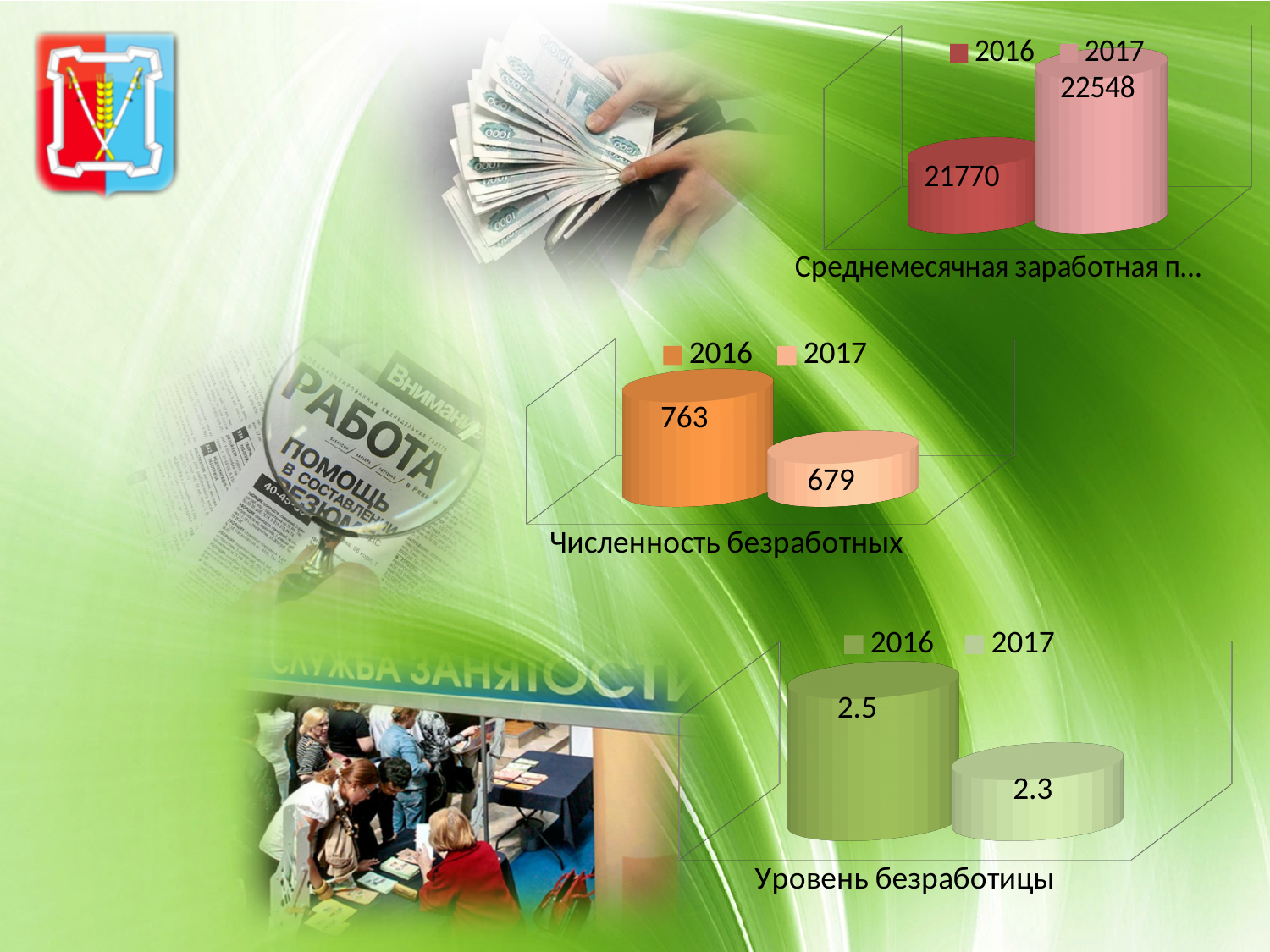
In the chart titled 'Уровень безработицы', does the value rise or fall from 2016 to 2017? fall What kind of chart is the chart titled 'Численность безработных'? bar chart In the chart titled 'Уровень безработицы', what is the value for 2017? 2.3 In the top-right chart (Среднемесячная заработная п...), what is the difference between the 2017 and 2016 values? 778 In the top-right chart (Среднемесячная заработная п...), what is the value for 2016? 21770 In the chart titled 'Уровень безработицы', what is the value for 2016? 2.5 In the chart titled 'Численность безработных', by how much did the value fall from 2016 to 2017? 84 In the chart titled 'Численность безработных', what is the value for 2017? 679 In the chart titled 'Численность безработных', which year has the higher value, 2016 or 2017? 2016 In the chart titled 'Численность безработных', what is the value for 2016? 763 In the top-right chart (Среднемесячная заработная п...), what is the value for 2017? 22548 How many series does the legend of the chart titled 'Уровень безработицы' list? 2